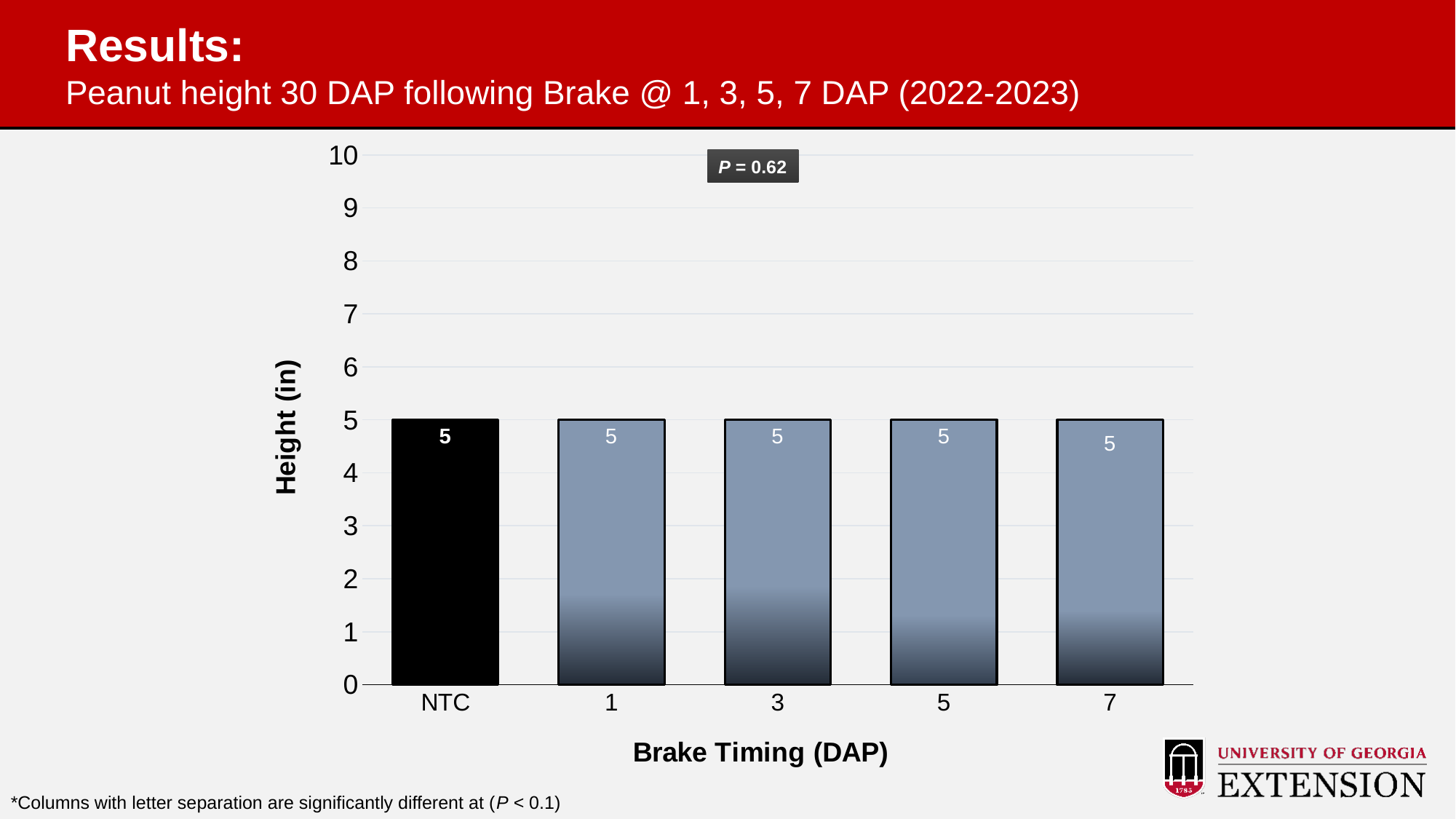
What is the height value for Brake applied at 1 DAP? 5 How many brake timing categories are shown on the x axis? 5 What is the label of the y axis? Height (in) Is the height value for the 3 DAP treatment greater or less than 4? greater What is the height value for Brake applied at 7 DAP? 5 Do the height values rise, fall, or stay the same across the brake timing categories? stay the same Is the height value for the NTC treatment greater or less than 6? less What is the height value for Brake applied at 3 DAP? 5 What is the difference in height between the NTC and the 5 DAP treatment? 0 What is the P value shown on the chart? 0.62 What kind of chart is shown on the slide? bar chart What is the peanut height for the NTC treatment? 5